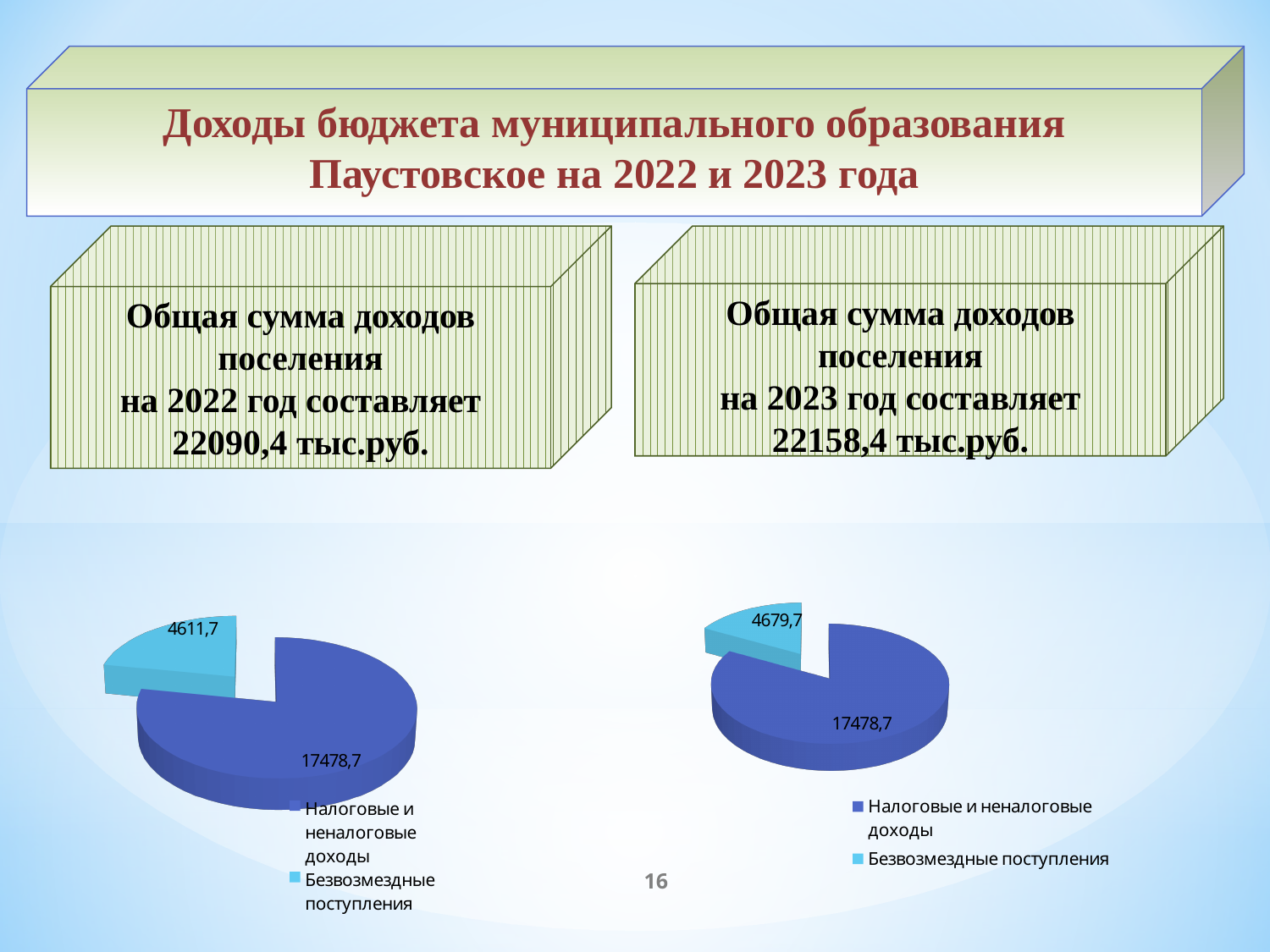
In the left pie chart, what is the value for Налоговые и неналоговые доходы? 17478,7 How many entries does the legend of the left pie chart list? 2 Which is larger: Безвозмездные поступления in the left pie chart or in the right pie chart? Right pie chart (4679,7) In the right pie chart, what is the value for Безвозмездные поступления? 4679,7 In the left pie chart, what is the difference between Налоговые и неналоговые доходы and Безвозмездные поступления? 12867,0 In the left pie chart, which category has the largest slice? Налоговые и неналоговые доходы How many slices does the right pie chart have? 2 In the right pie chart, what is the value for Налоговые и неналоговые доходы? 17478,7 In the right pie chart, which category has the smallest slice? Безвозмездные поступления In the right pie chart, what is the difference between Налоговые и неналоговые доходы and Безвозмездные поступления? 12799,0 In the left pie chart, what is the value for Безвозмездные поступления? 4611,7 What kind of chart is shown on the left side of the slide? Pie chart